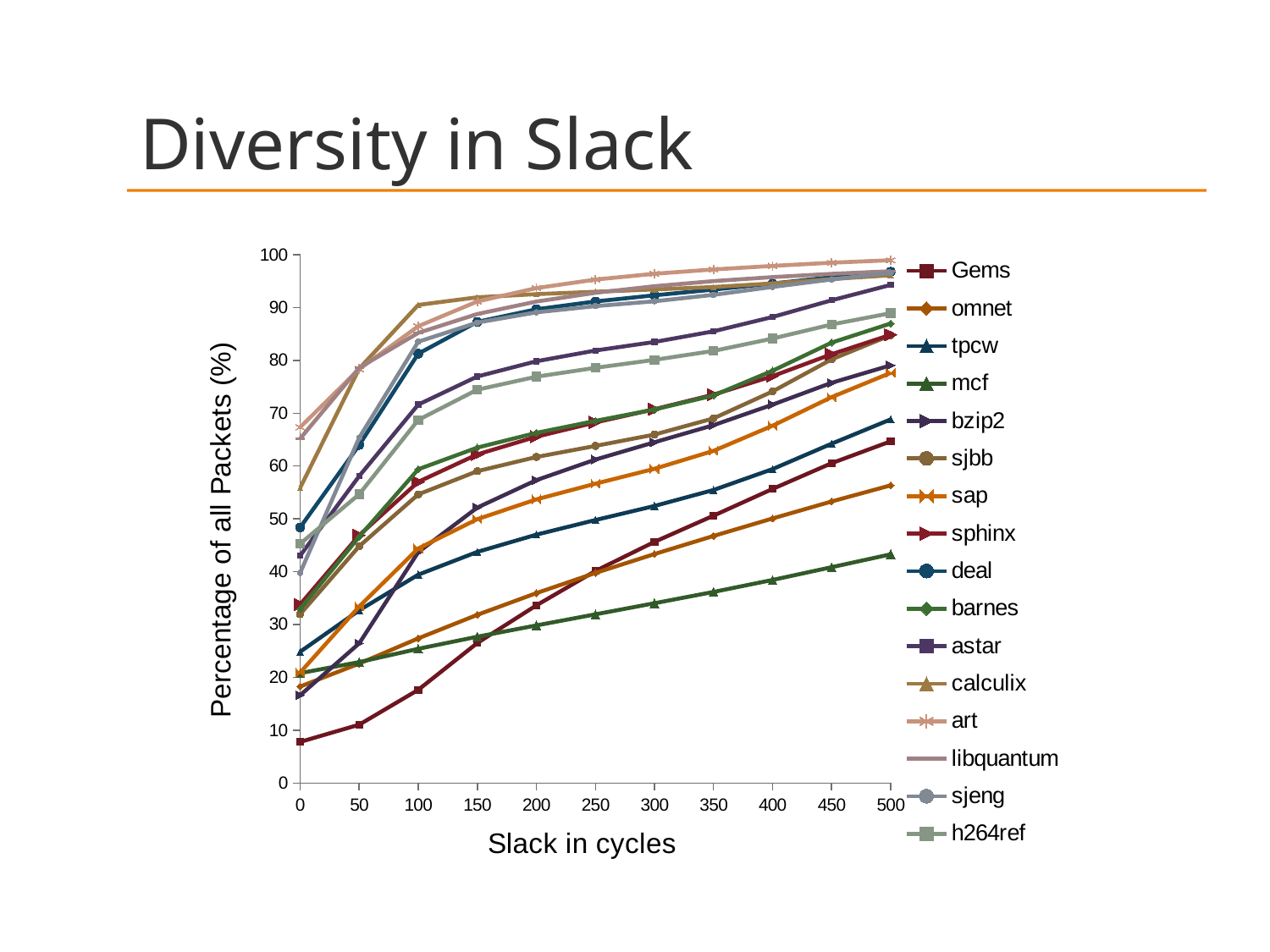
Is the value for art at a slack of 500 cycles greater or less than 90? greater Which series has the lowest percentage of packets at a slack of 0 cycles? Gems What kind of chart is shown on the slide? line chart Is the value for Gems at a slack of 0 cycles greater or less than 10? less What is the label of the y-axis? Percentage of all Packets (%) Which series has the lowest percentage of packets at a slack of 500 cycles? mcf How many slack values (x-axis points) are plotted for each series? 11 What is the title of the slide? Diversity in Slack Is the value for mcf at a slack of 500 cycles greater or less than 50? less At a slack of 500 cycles, which is larger: Gems or mcf? Gems Do the series rise or fall as slack in cycles increases? rise How many series does the legend list? 16